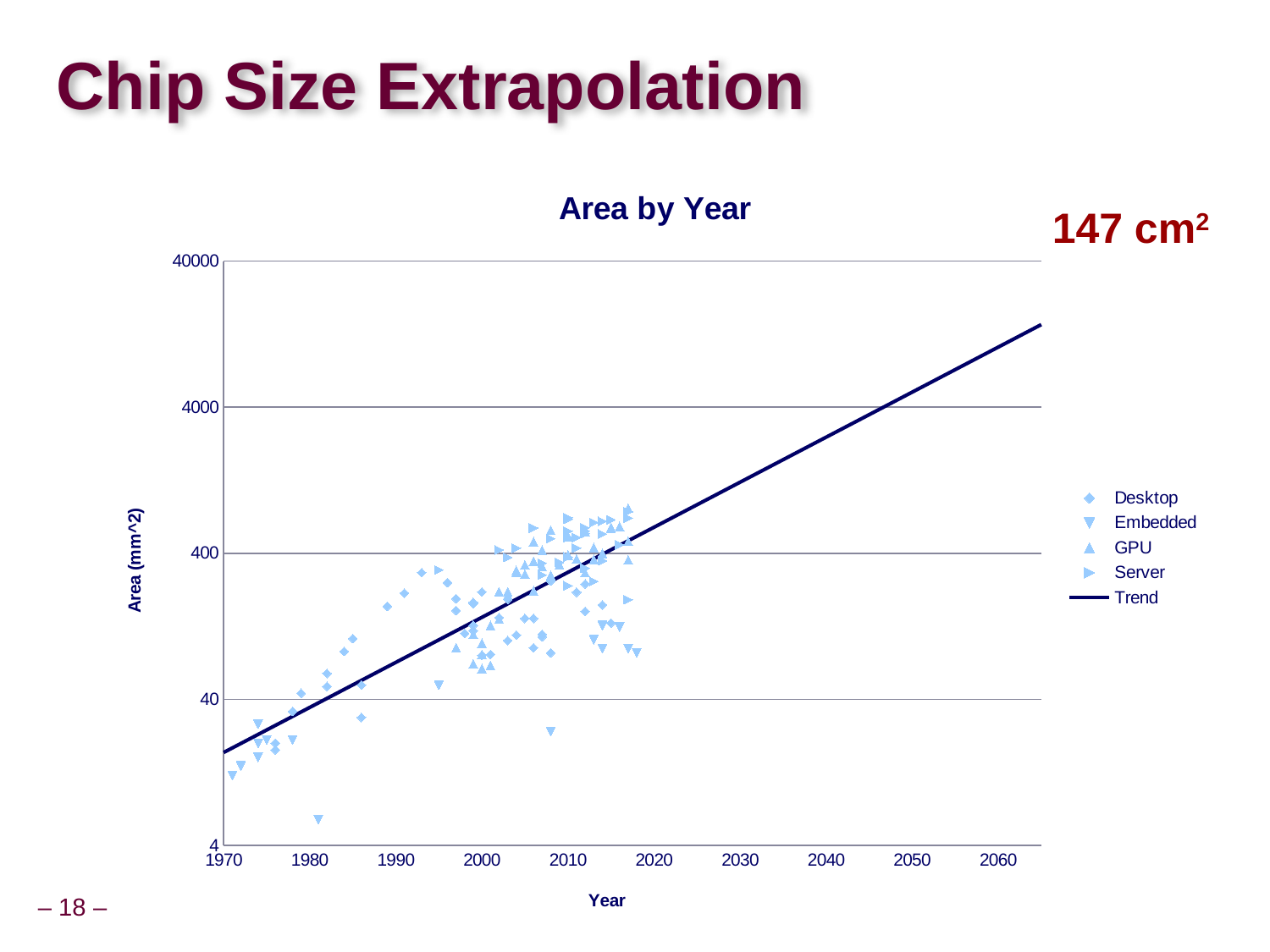
Does the Trend line rise or fall as the year increases? rises What is the title of the chart? Area by Year What is the label of the y axis? Area (mm^2) Is the value of the Trend line at 2000 greater or less than 400? less What kind of chart is shown on the slide? scatter chart What is the last year shown on the x axis? 2060 What is the highest value shown on the y axis? 40000 Is the value of the Trend line at 2030 greater or less than 400? greater What value is annotated in the top right corner of the chart? 147 cm² Is the value of the Trend line at 1970 greater or less than 40? less How many entries does the chart legend list? 5